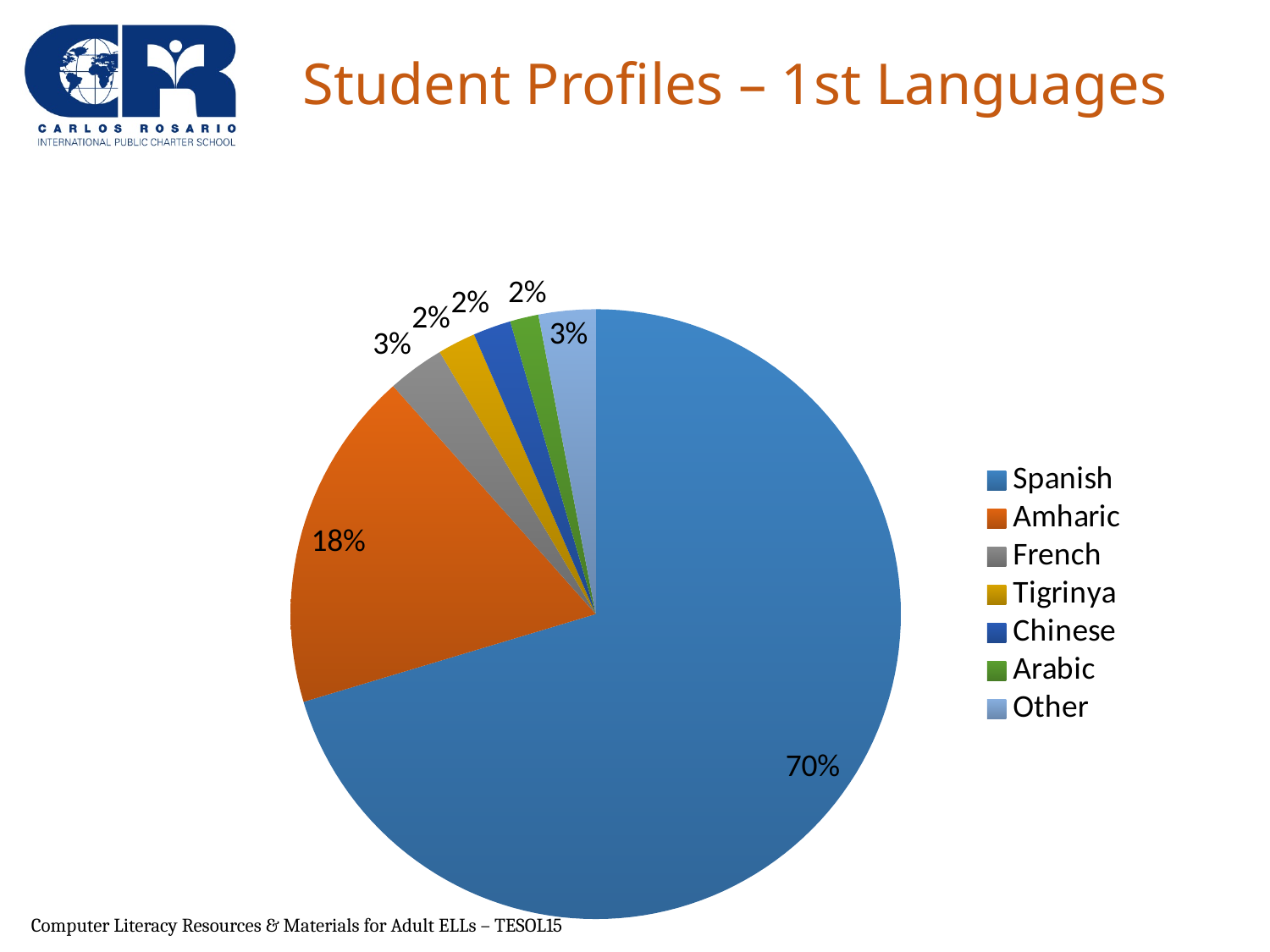
What is the title of the slide containing the chart? Student Profiles – 1st Languages What share of the pie does Tigrinya represent? 2% What is the difference between the Spanish share and the Amharic share? 52% What share of the pie does Amharic represent? 18% How many entries does the legend list? 7 Which language has the largest slice of the pie? Spanish Which is larger, the share for Amharic or the share for French? Amharic What share of the pie does Spanish represent? 70% How many slices does the pie chart have? 7 What kind of chart is shown on the slide? pie chart What share of the pie does Other represent? 3% What share of the pie does French represent? 3%